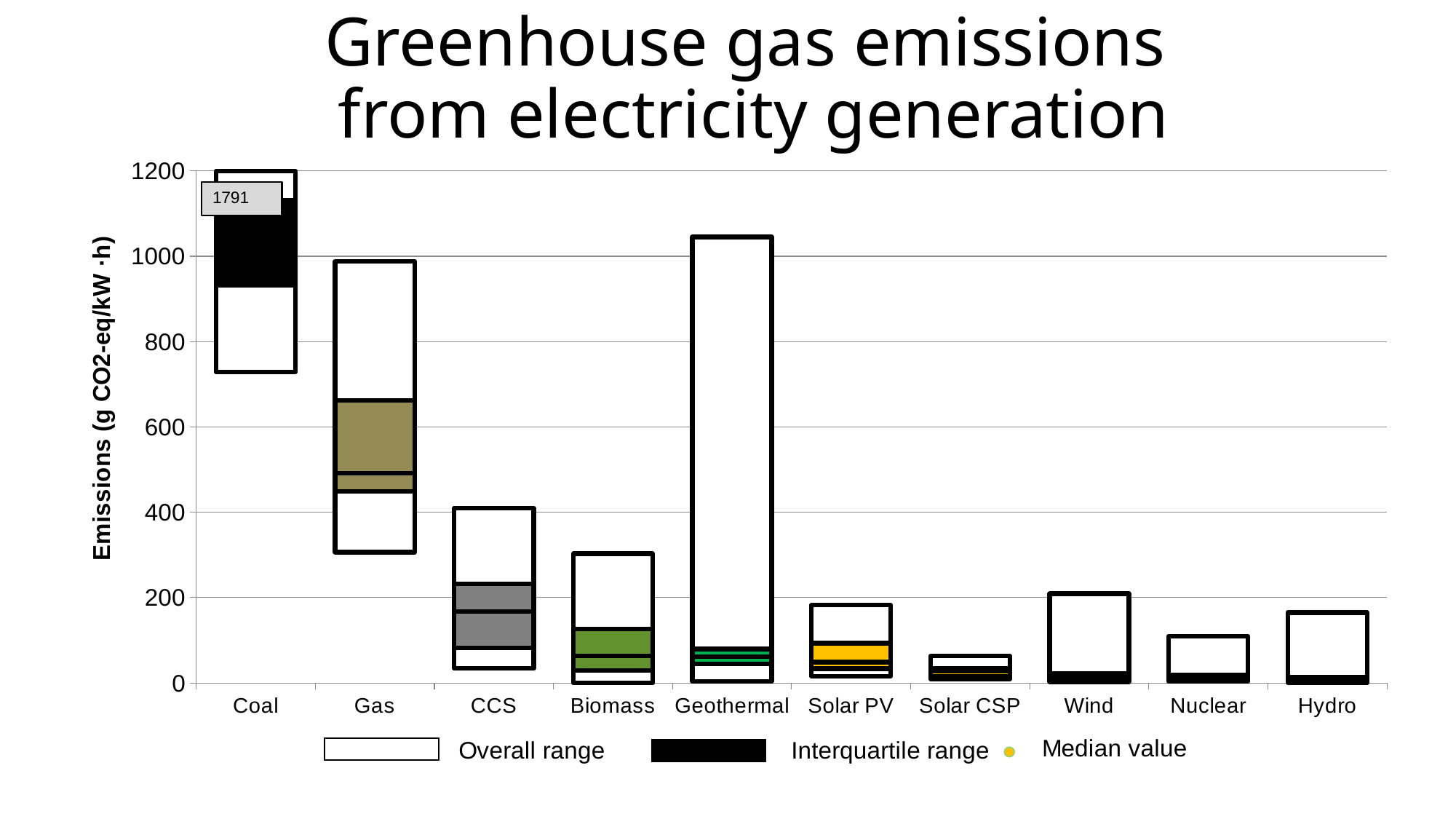
How many entries does the legend list? 3 What value is printed as a data label on the Coal bar? 1791 What is the label of the y axis? Emissions (g CO2-eq/kW·h) Which category has the lowest upper value of its overall range? Solar CSP Is the top of the overall range for Gas greater or less than 800? greater Which has a higher top of its overall range, Geothermal or Biomass? Geothermal What is the title of the chart? Greenhouse gas emissions from electricity generation How many electricity generation categories are shown on the x axis? 10 Is the top of the overall range for Biomass greater or less than 200? greater Is the top of the overall range for Nuclear greater or less than 200? less Which category has the highest upper value of its overall range? Coal What kind of chart is shown on the slide? bar chart